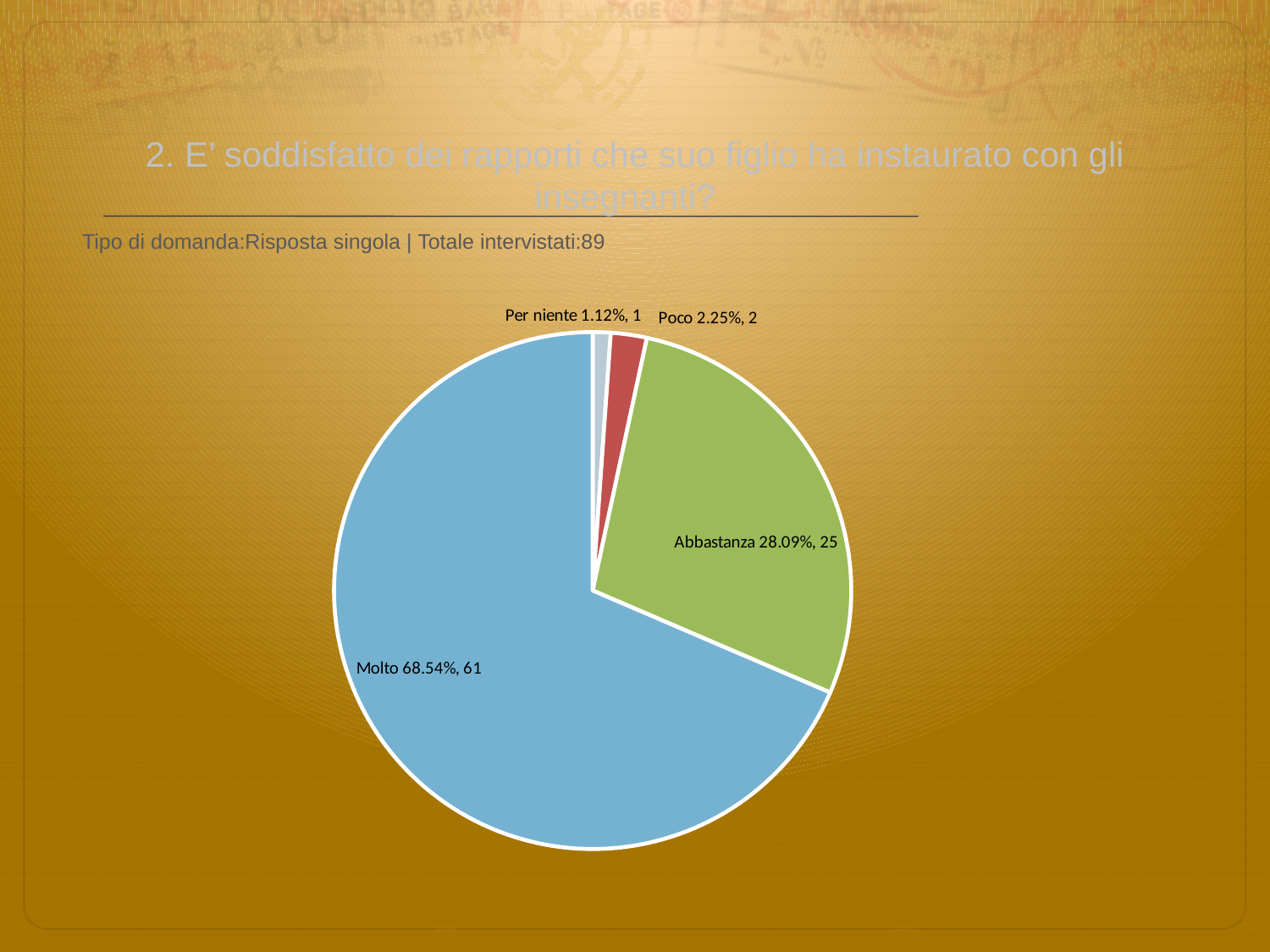
What percentage share does the Molto slice have? 68.54% What percentage share does the Poco slice have? 2.25% What is the difference in respondent count between Molto and Abbastanza? 36 What is the total number of respondents across all slices? 89 How many slices does the pie chart have? 4 What colour is the Abbastanza slice? green Which has more respondents, Poco or Per niente? Poco Which category has the smallest slice? Per niente Which category has the largest slice? Molto What kind of chart is shown on the slide? pie chart How many respondents answered Per niente? 1 How many respondents answered Abbastanza? 25